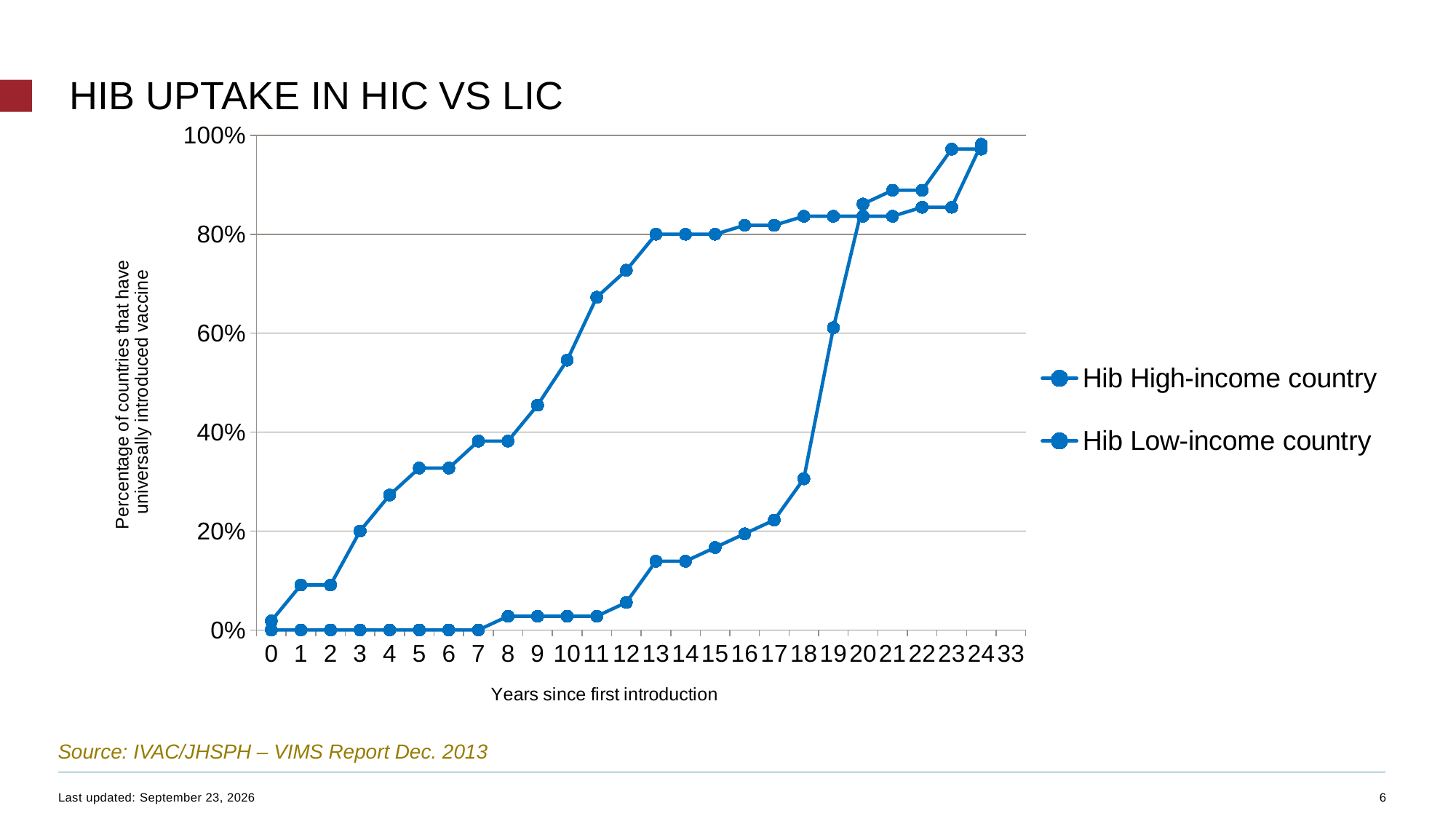
What is the value of the lower line at year 0? 0% Do the values of both lines generally rise or fall as years since first introduction increase? Rise Is the value of the lower line at year 18 greater or less than 20%? greater What is the label of the x axis? Years since first introduction At year 10, which line has the larger value, the upper line or the lower line? The upper line Is the value of the upper line at year 12 greater or less than 60%? greater What is the value of the lower line at year 7? 0% How many series does the legend list? 2 Is the value of the upper line at year 10 greater or less than 60%? less What kind of chart is shown on the slide? Line chart What are the two series named in the legend? Hib High-income country; Hib Low-income country